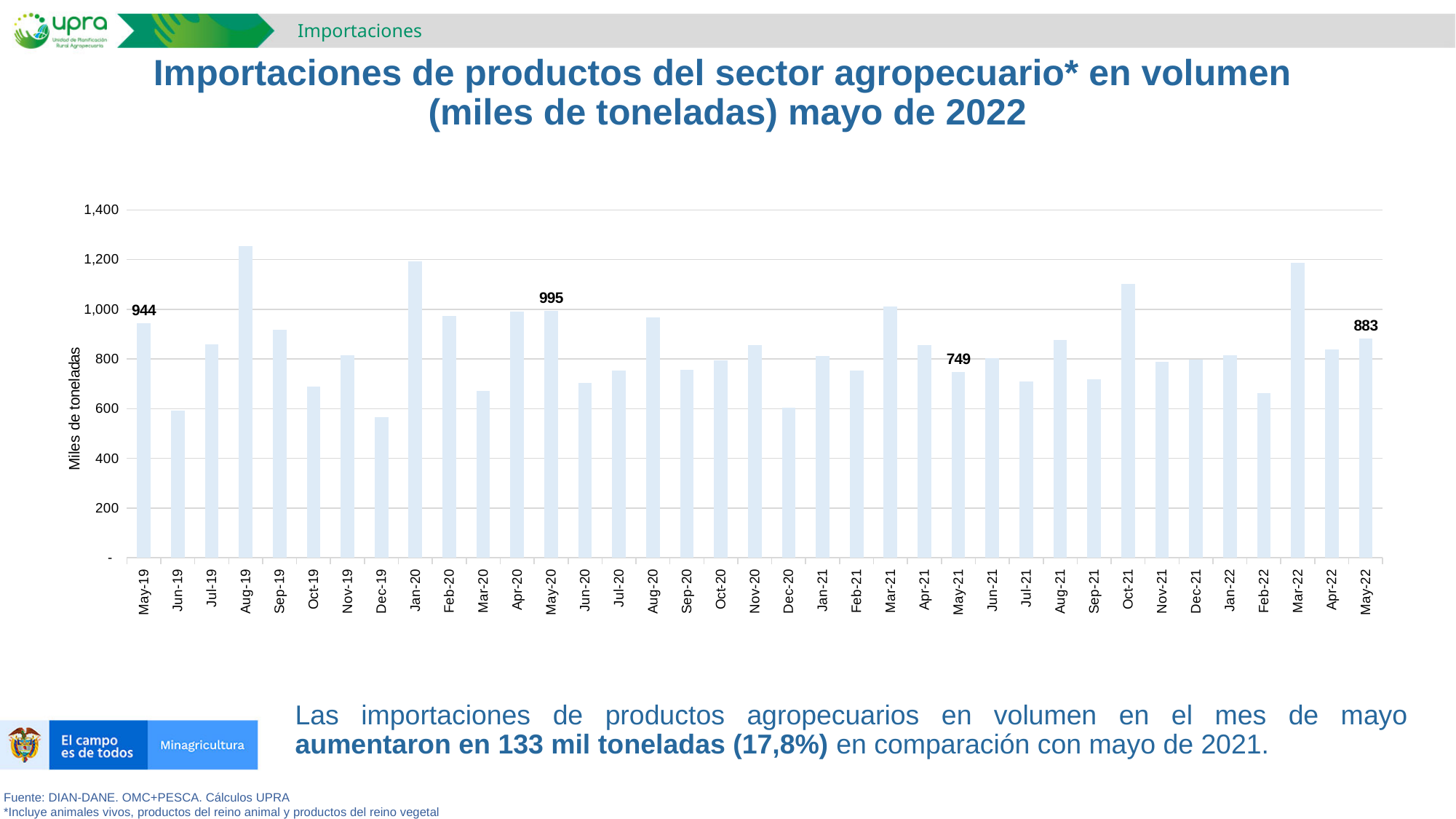
What is the value for May-19? 944 What is the value for May-20? 995 What is the difference between the values for May-20 and May-21? 246 Is the value for Feb-22 greater or less than 800? less Which is larger, the value for May-19 or the value for May-22? May-19 What is the difference between the values for May-20 and May-19? 51 What is the value for May-21? 749 What kind of chart is shown on the slide? Bar chart How many months are plotted in the chart? 37 Is the value for Aug-19 greater or less than 1,200? greater What is the value for May-22? 883 Which month has the highest bar in the chart? Aug-19